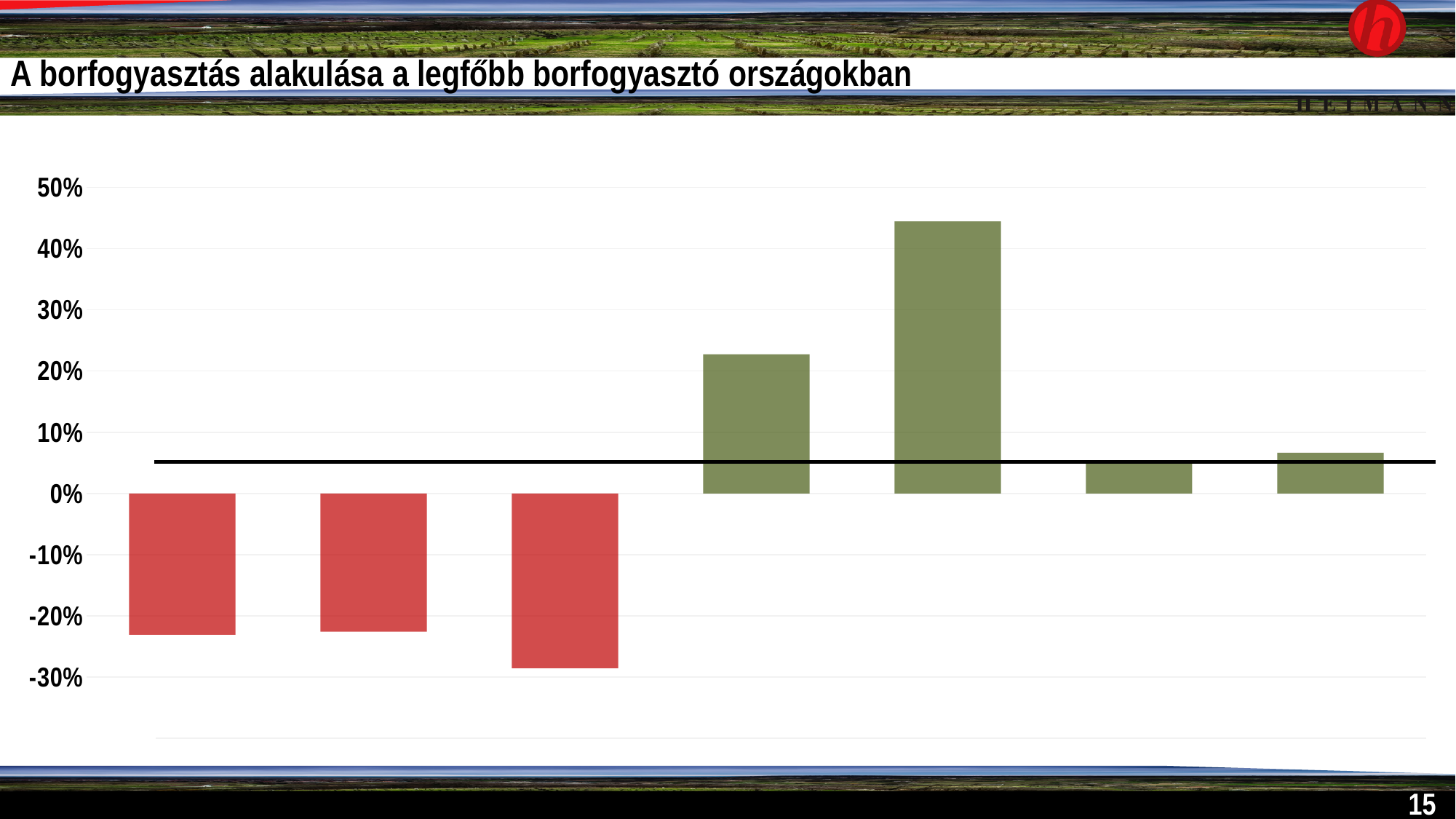
Is the value of the first bar from the left greater or less than -20%? less What is the title of the slide containing the chart? A borfogyasztás alakulása a legfőbb borfogyasztó országokban How many bars in the chart are coloured red? 3 Which is larger, the value of the fourth bar from the left or the fifth bar from the left? the fifth bar How many bars are plotted in the chart? 7 Which bar, counted from the left, is the highest in the chart? the fifth bar What kind of chart is shown on the slide? bar chart Is the value of the third bar from the left greater or less than -30%? greater Which bar, counted from the left, is the lowest in the chart? the third bar Is the value of the fifth bar from the left greater or less than 40%? greater